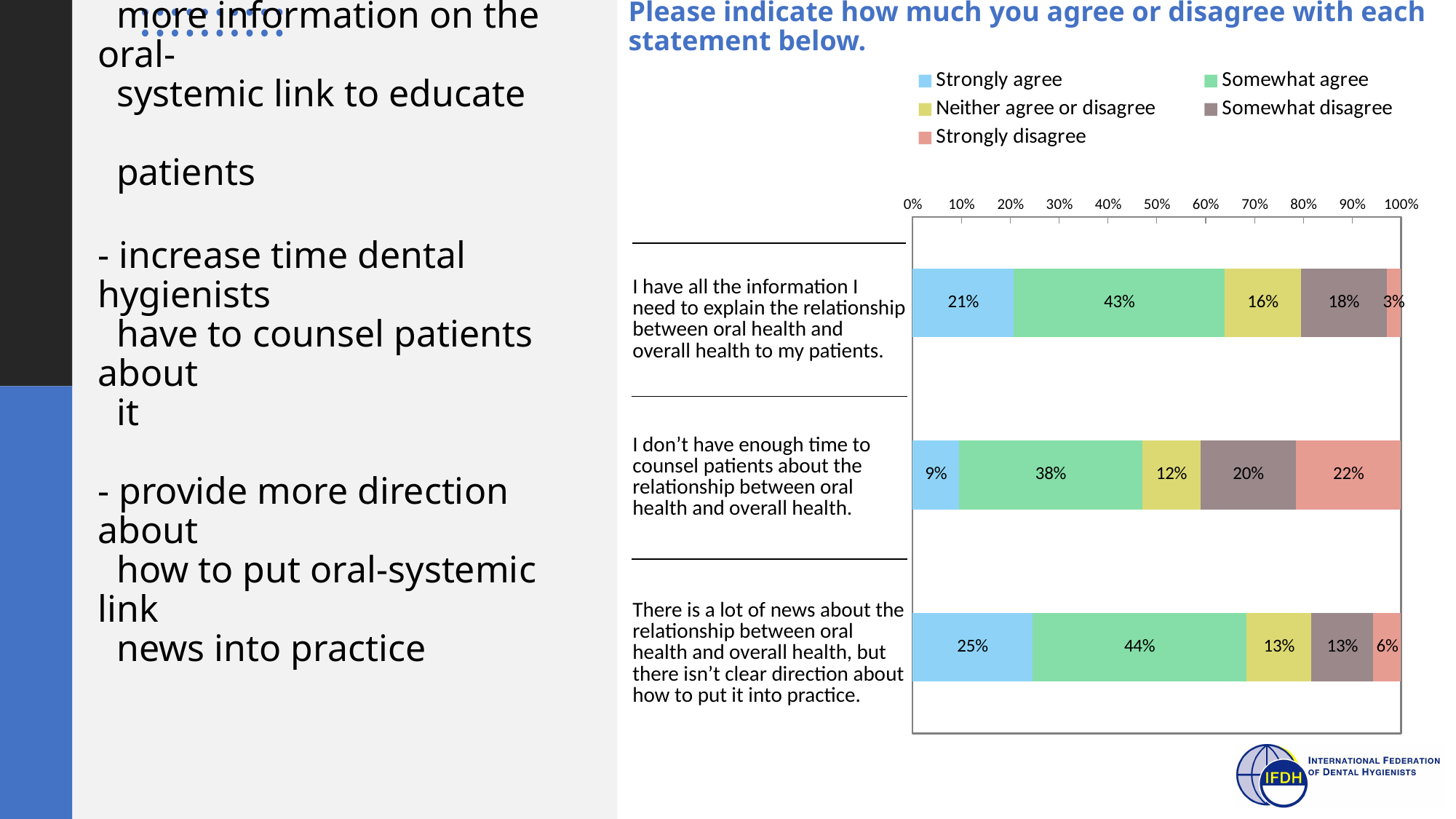
How many statements (categories) are plotted in the chart? 3 What percentage strongly agree with the statement 'I have all the information I need to explain the relationship between oral health and overall health to my patients'? 21% What percentage somewhat agree with the statement 'There is a lot of news about the relationship between oral health and overall health, but there isn't clear direction about how to put it into practice'? 44% What kind of chart is shown on the slide? Stacked bar chart What is the difference between the 'Strongly agree' percentages for the 'There is a lot of news...' statement and the 'I don't have enough time...' statement? 16% What percentage strongly disagree with the statement 'I don't have enough time to counsel patients about the relationship between oral health and overall health'? 22% How many series does the chart legend list? 5 Which is larger: the 'Somewhat disagree' share for 'I don't have enough time to counsel patients...' or for 'There is a lot of news...'? I don't have enough time to counsel patients about the relationship between oral health and overall health. Which statement has the lowest 'Strongly agree' percentage? I don't have enough time to counsel patients about the relationship between oral health and overall health. What percentage somewhat agree with the statement 'I don't have enough time to counsel patients about the relationship between oral health and overall health'? 38% Which legend entry is shown in light blue? Strongly agree Which statement has the highest 'Strongly agree' percentage? There is a lot of news about the relationship between oral health and overall health, but there isn't clear direction about how to put it into practice.